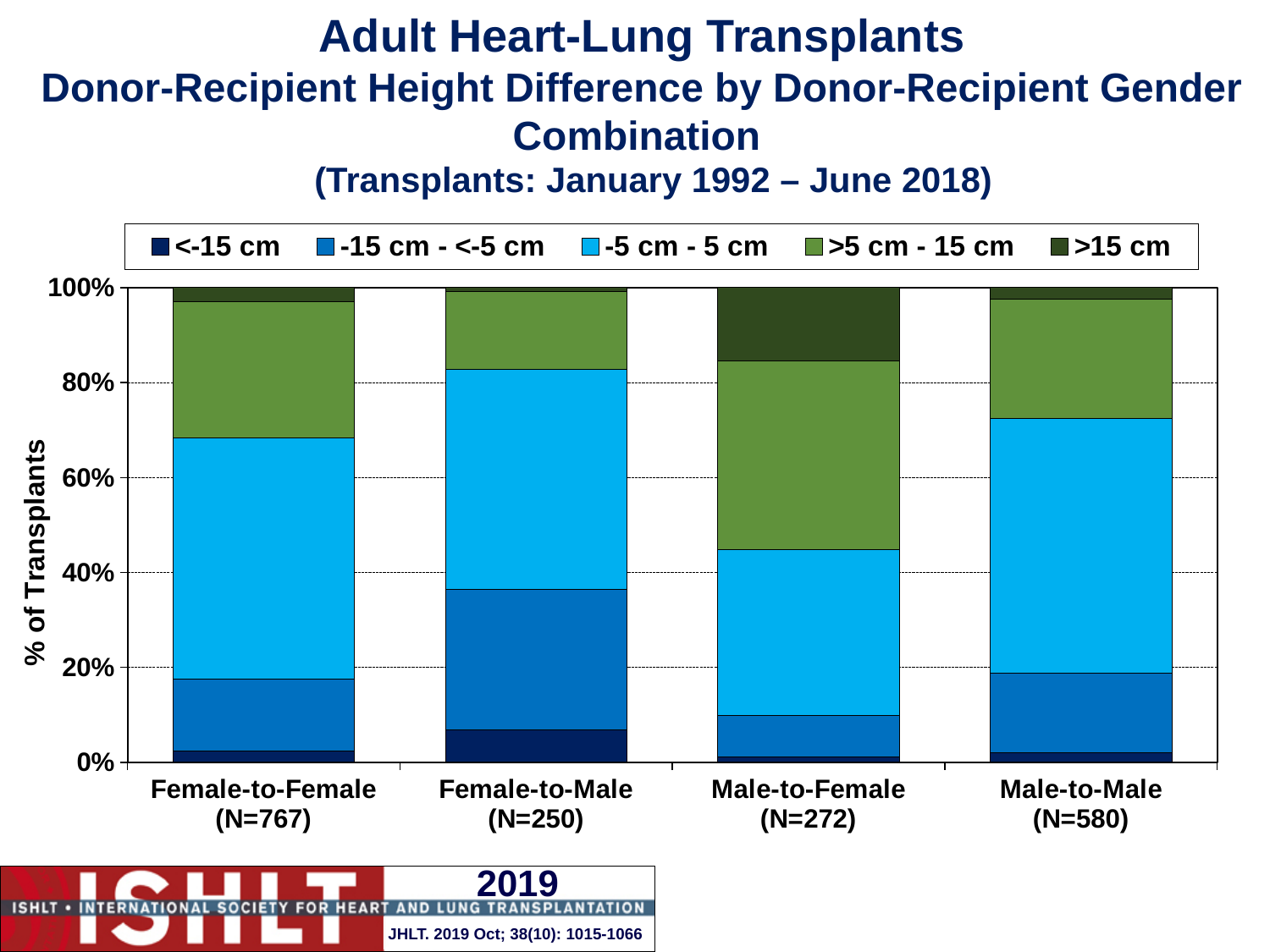
Is the '>5 cm - 15 cm' segment for Male-to-Female greater or less than 20%? greater What is the label of the y axis? % of Transplants Which gender combination has the largest '<-15 cm' segment? Female-to-Male Which gender combination has the largest '>15 cm' segment? Male-to-Female What kind of chart is shown on the slide? Stacked bar chart What is the number of transplants (N) shown for the Male-to-Male group? N=580 Is the '-5 cm - 5 cm' segment for Female-to-Female greater or less than 40%? greater Which gender combination has the smallest '-5 cm - 5 cm' segment? Male-to-Female How many donor-recipient gender combinations are shown on the x axis? 4 Which gender combination has the largest '>5 cm - 15 cm' segment? Male-to-Female Is the '-15 cm - <-5 cm' segment for Male-to-Male greater or less than 20%? less How many height-difference categories does the legend list? 5